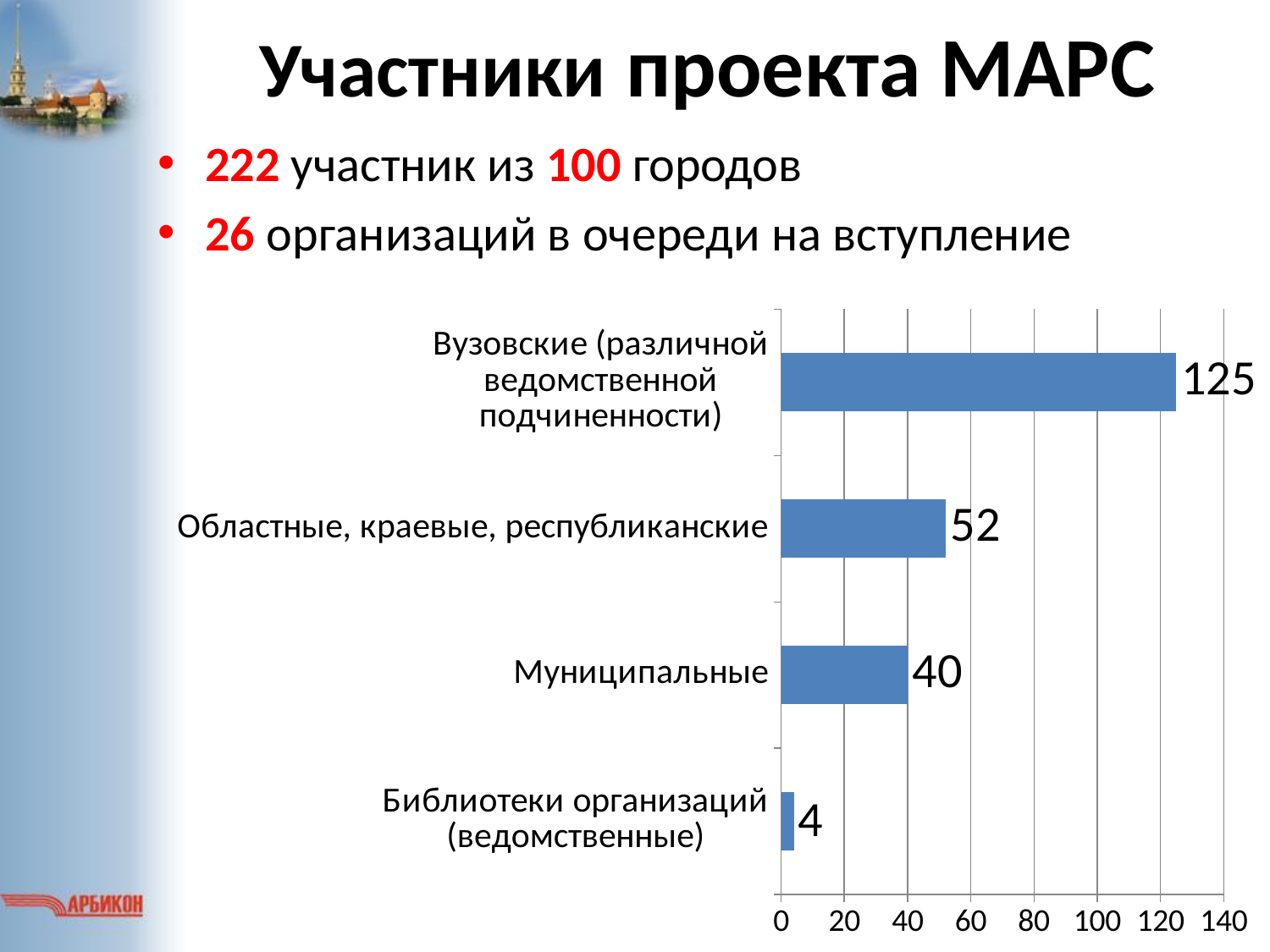
What is the difference between the values for Областные, краевые, республиканские and Муниципальные? 12 What kind of chart is shown on the slide? bar chart Which is larger, the value for Муниципальные or the value for Библиотеки организаций (ведомственные)? Муниципальные What is the value for Муниципальные? 40 How many categories are shown in the chart? 4 What is the difference between the values for Вузовские (различной ведомственной подчиненности) and Областные, краевые, республиканские? 73 Which category has the highest value? Вузовские (различной ведомственной подчиненности) Is the value for Вузовские (различной ведомственной подчиненности) greater or less than 100? greater What is the value for Вузовские (различной ведомственной подчиненности)? 125 What is the value for Областные, краевые, республиканские? 52 What is the value for Библиотеки организаций (ведомственные)? 4 Which category has the lowest value? Библиотеки организаций (ведомственные)